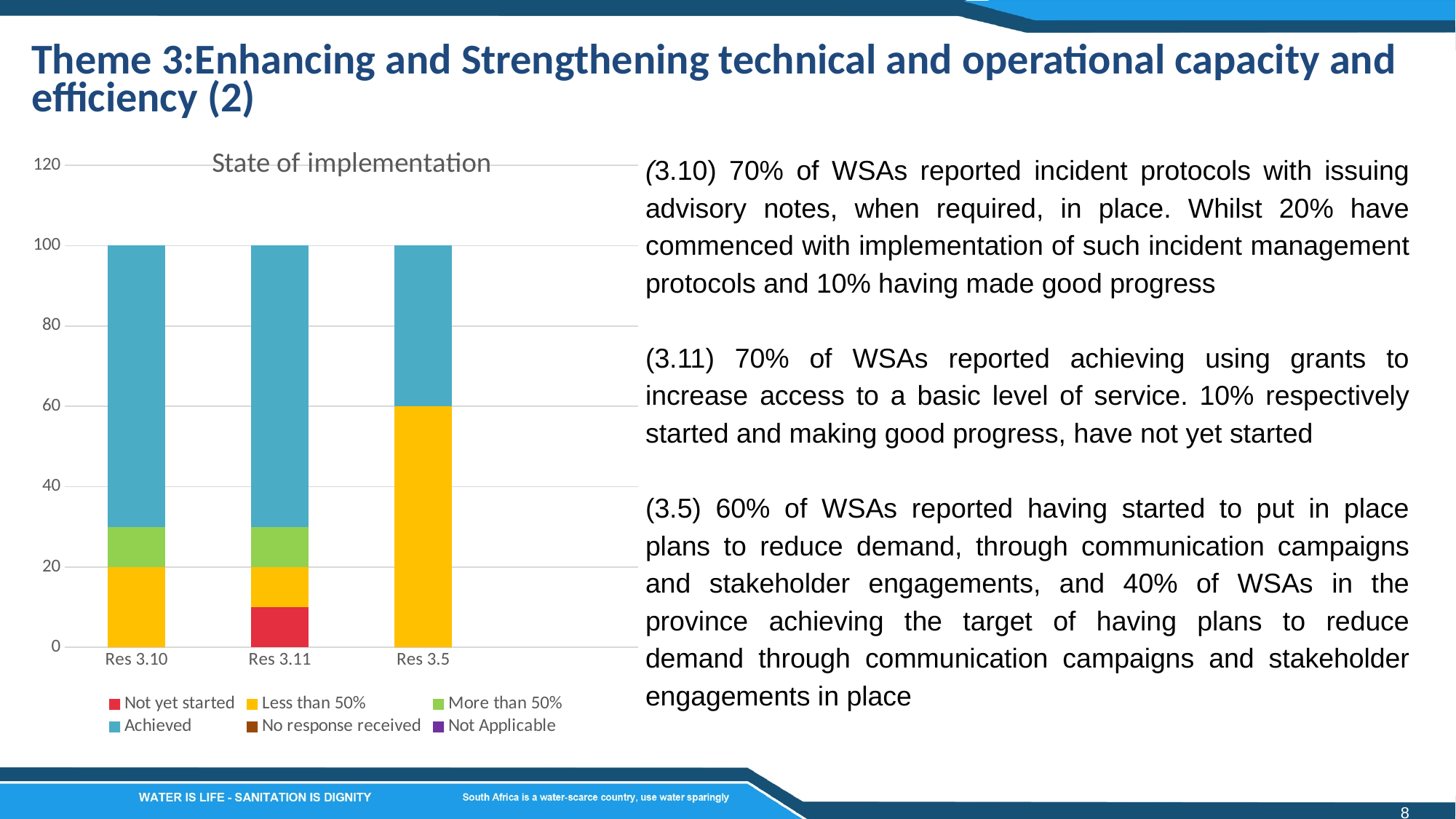
Which has a larger 'Achieved' segment, Res 3.11 or Res 3.5? Res 3.11 Is the 'Achieved' value for Res 3.10 greater or less than 60? greater What type of chart is shown on the slide? Stacked bar chart How many series does the chart legend list? 6 Is the 'Not yet started' value for Res 3.11 greater or less than 20? less What is the total height of the stacked bar for Res 3.5? 100 Which category is the only one with a 'Not yet started' segment? Res 3.11 What is the title of the chart? State of implementation How many categories are shown on the x axis of the chart? 3 What is the value of the 'Less than 50%' segment for Res 3.5? 60 What is the value of the 'Less than 50%' segment for Res 3.10? 20 Which category has the largest 'Less than 50%' segment? Res 3.5